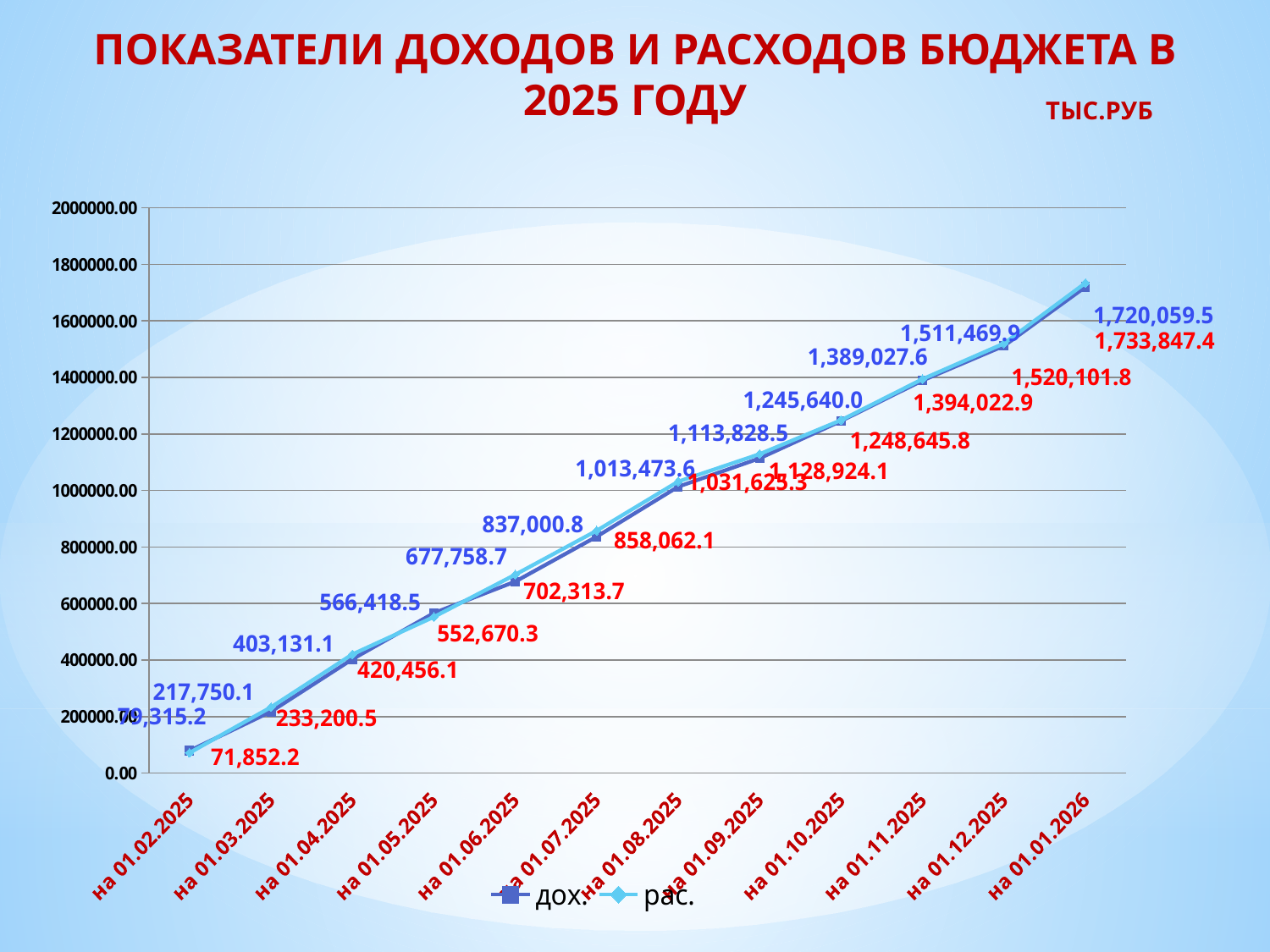
What is the value of рас. on 01.07.2025? 858,062.1 On which date is the value of рас. highest? на 01.01.2026 Do the values of дох. rise or fall from 01.02.2025 to 01.01.2026? rise What is the difference between рас. and дох. on 01.12.2025? 8,631.9 Which is larger on 01.04.2025, дох. or рас.? рас. How many dates are plotted along the x axis? 12 What is the value of рас. on 01.03.2025? 233,200.5 How many series does the legend list? 2 What is the value of дох. on 01.01.2026? 1,720,059.5 What kind of chart is shown on the slide? line chart On which date is the value of дох. lowest? на 01.02.2025 What is the value of дох. on 01.05.2025? 566,418.5